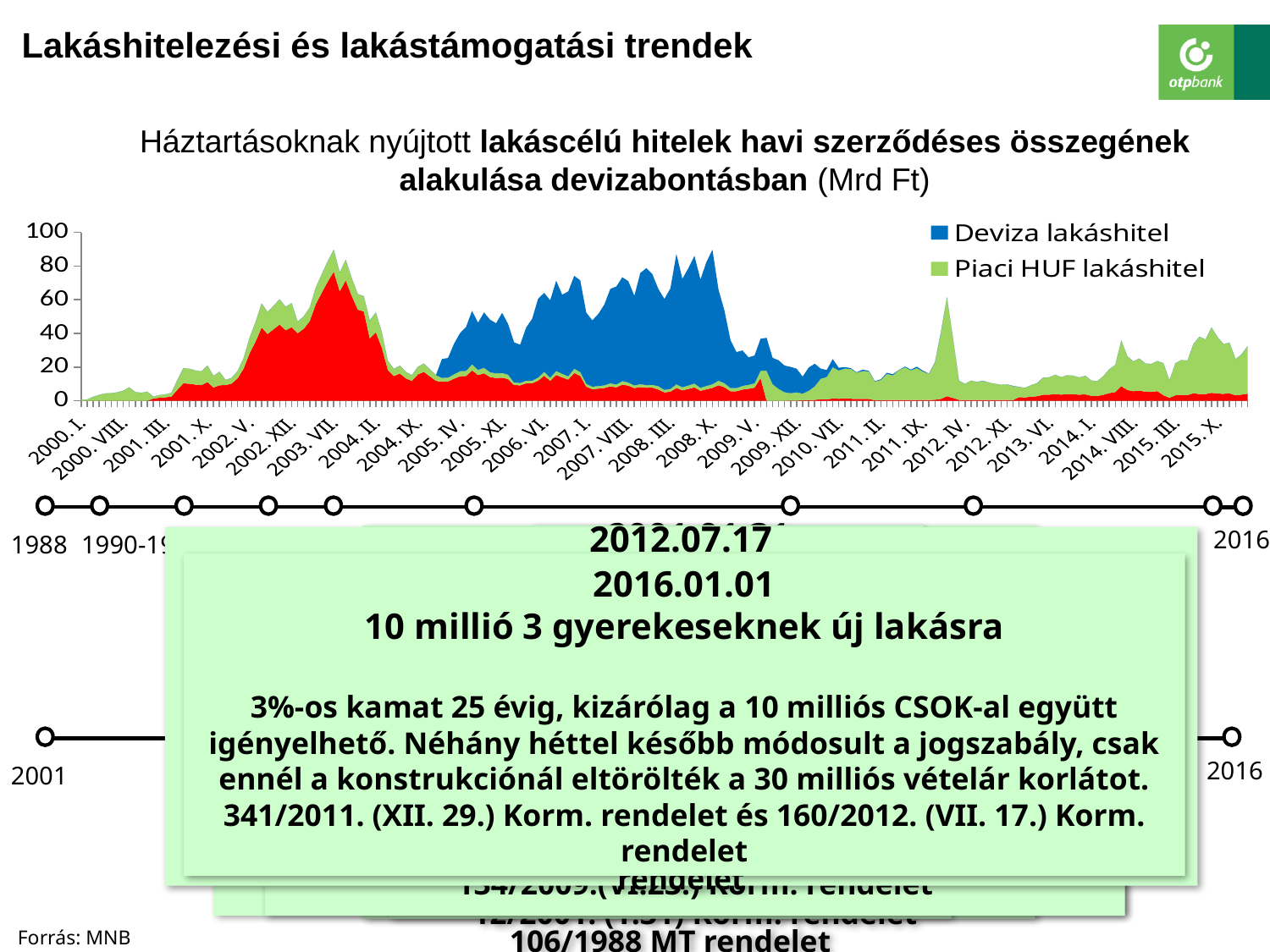
Is the total stacked value around 2013. VI. greater or less than 20? less What kind of chart is shown on the slide? area chart Is the total stacked value around 2003. VII. greater or less than 80? greater Does the total stacked value rise or fall between 2008. X. and 2009. XII.? fall What is the first category label on the chart's horizontal axis? 2000. I. Is the total stacked value at 2000. I. greater or less than 20? less Which series does the legend associate with the blue colour? Deviza lakáshitel How many series does the chart's legend list? 2 What is the highest value shown on the chart's vertical axis? 100 Which series does the legend associate with the green colour? Piaci HUF lakáshitel What is the last category label on the chart's horizontal axis? 2015. X.